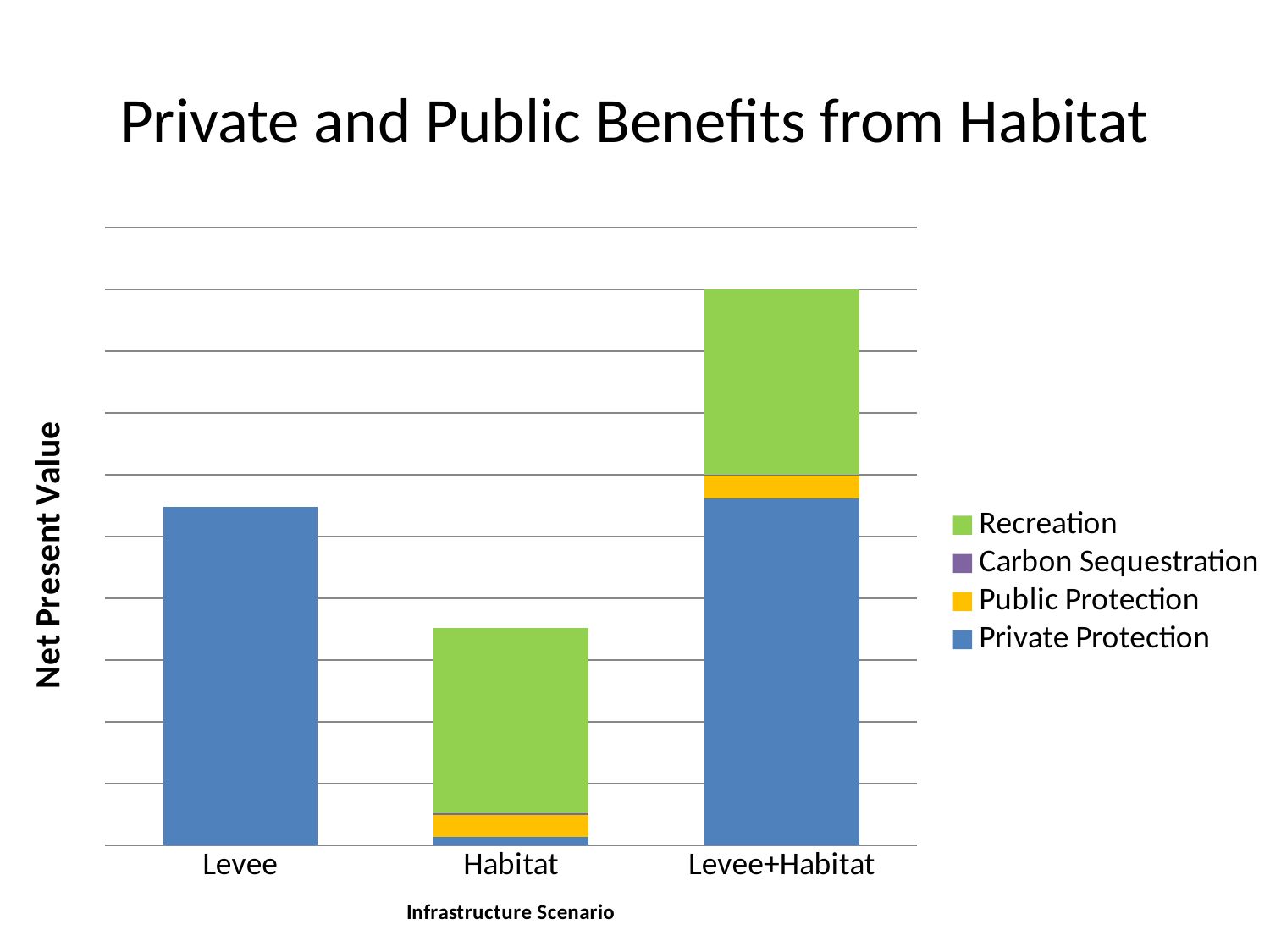
Which infrastructure scenario has the highest total net present value? Levee+Habitat How many infrastructure scenarios are shown on the x axis? 3 How many series does the legend list? 4 What is the label of the y axis? Net Present Value Which scenario's bar consists only of Private Protection? Levee Which has a larger total net present value, Levee or Habitat? Levee Which has a larger Public Protection value, Habitat or Levee+Habitat? Neither; they are equal What kind of chart is shown on the slide? Stacked bar chart Which has a larger Private Protection value, Levee or Levee+Habitat? Levee+Habitat What is the title of the chart? Private and Public Benefits from Habitat Which infrastructure scenario has the lowest total net present value? Habitat